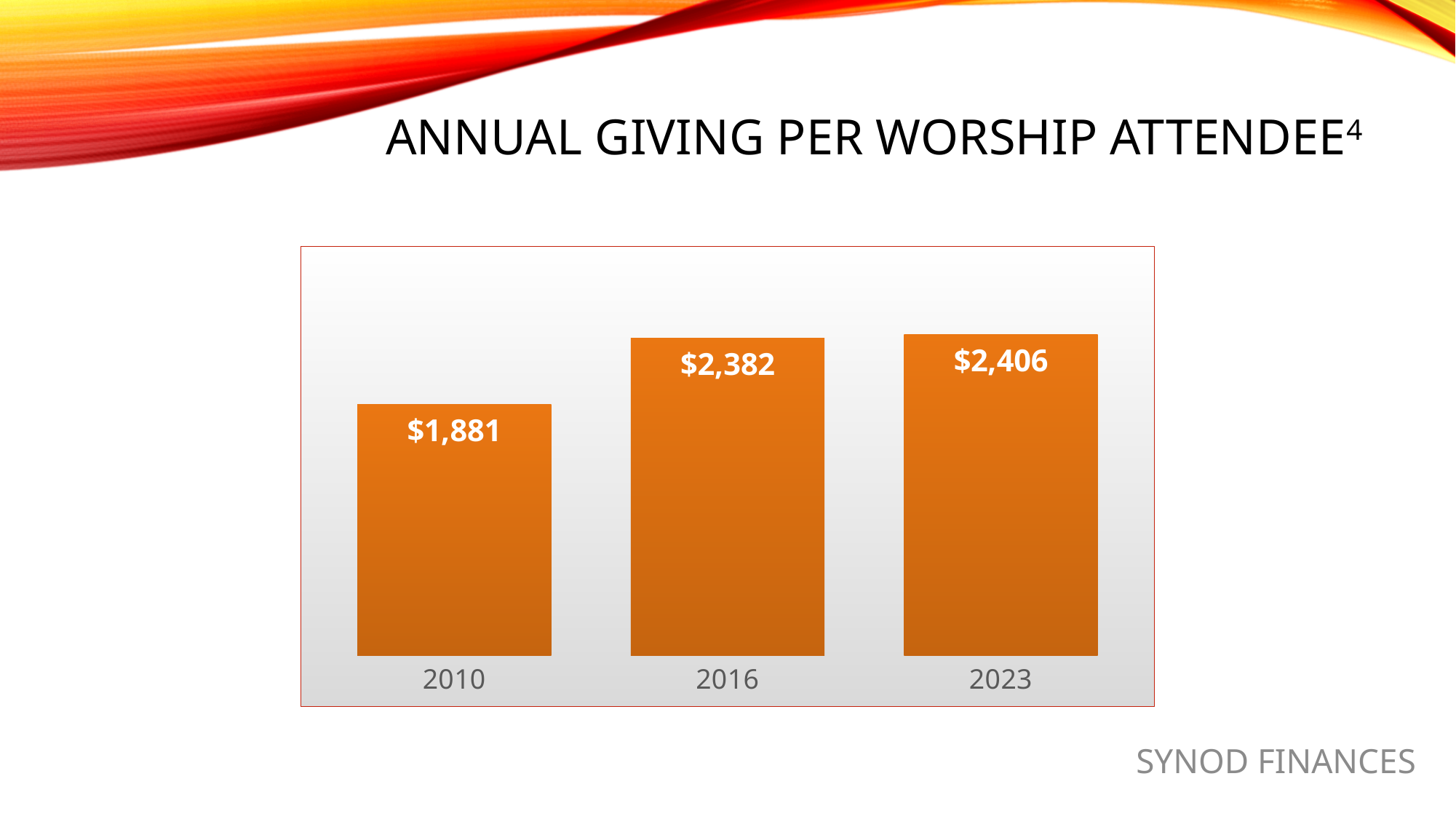
How many years are shown in the chart? 3 What is the annual giving per worship attendee for 2010? $1,881 What is the annual giving per worship attendee for 2016? $2,382 What is the difference in annual giving per worship attendee between 2016 and 2010? $501 Which year has the lowest annual giving per worship attendee? 2010 Which year has higher annual giving per worship attendee, 2010 or 2016? 2016 Do the values rise or fall from 2010 to 2023? Rise What is the difference in annual giving per worship attendee between 2023 and 2010? $525 What is the difference in annual giving per worship attendee between 2023 and 2016? $24 What kind of chart is shown on the slide? Bar chart What is the annual giving per worship attendee for 2023? $2,406 What is the title of the chart on the slide? Annual Giving per Worship Attendee